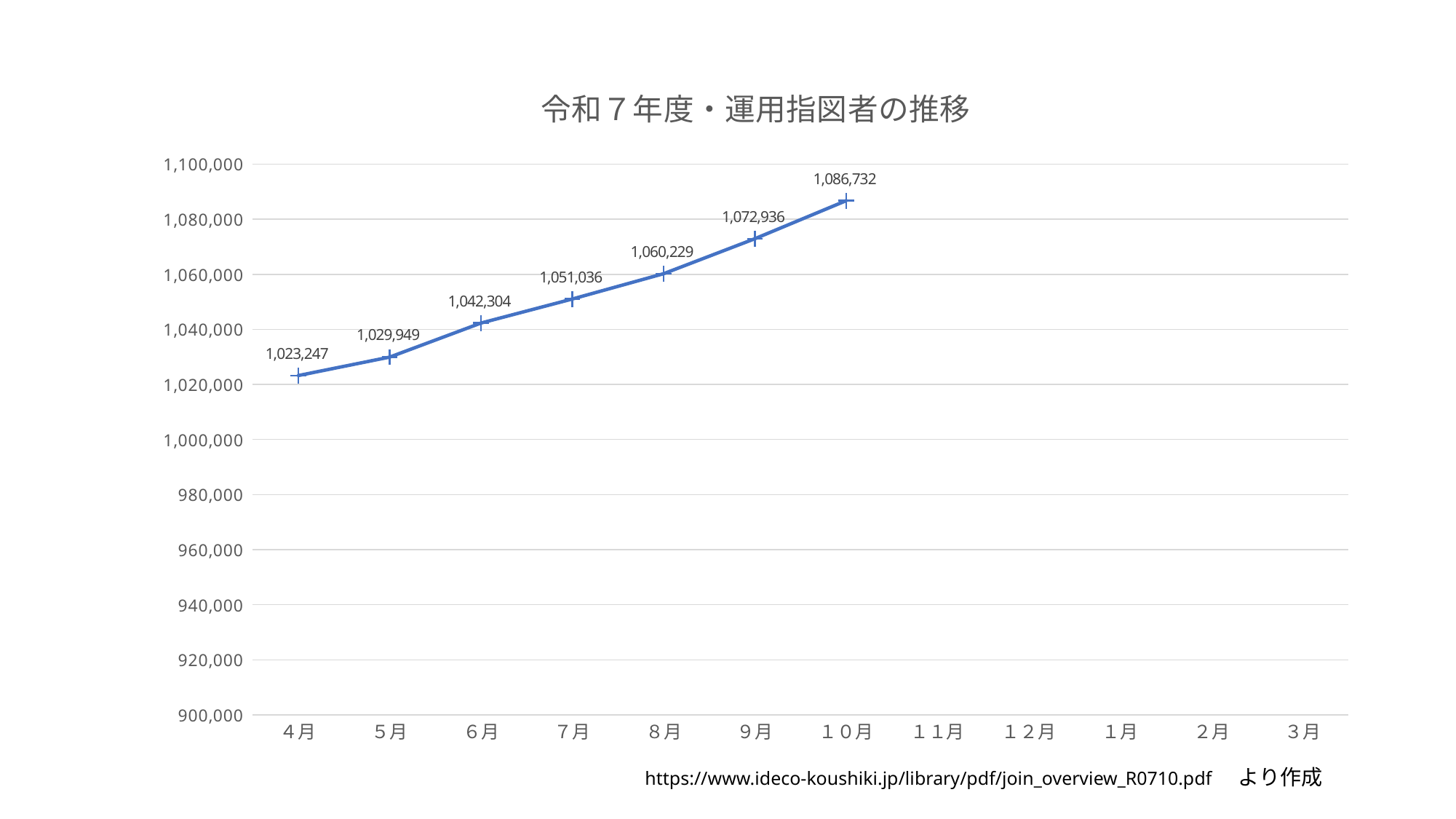
What kind of chart is shown? line chart Do the values rise or fall from 4月 to １０月? rise What is the value for 7月? 1,051,036 What is the value for 9月? 1,072,936 Which is larger, the value for 6月 or the value for 5月? 6月 Which month has the lowest value? ４月 What is the difference between the values for 9月 and 8月? 12,707 What is the difference between the values for １０月 and ４月? 63,485 How many data points are plotted on the line? 7 What is the value for 4月? 1,023,247 Which month has the highest value? １０月 Is the value for 8月 greater or less than 1,040,000? greater